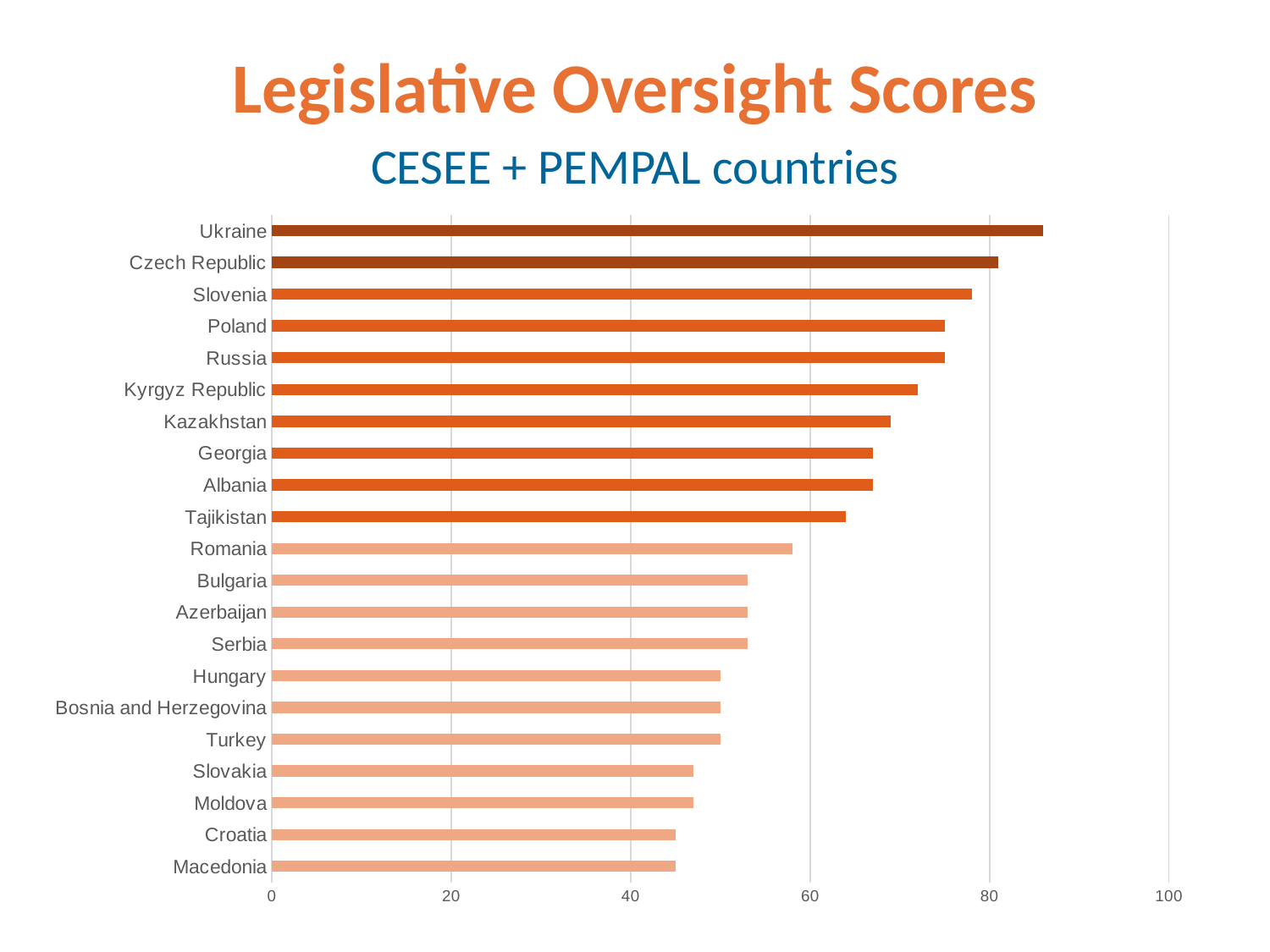
Is the value for Slovenia greater or less than 80? less Is the value for Tajikistan greater or less than 60? greater Is the value for Macedonia greater or less than 40? greater Which has a higher score, Czech Republic or Bulgaria? Czech Republic What is the subtitle shown below the chart title? CESEE + PEMPAL countries Which has a lower score, Kazakhstan or Croatia? Croatia What is the title of the chart? Legislative Oversight Scores How many countries are shown in the chart? 21 Which country has the highest legislative oversight score? Ukraine What kind of chart is shown on the slide? bar chart